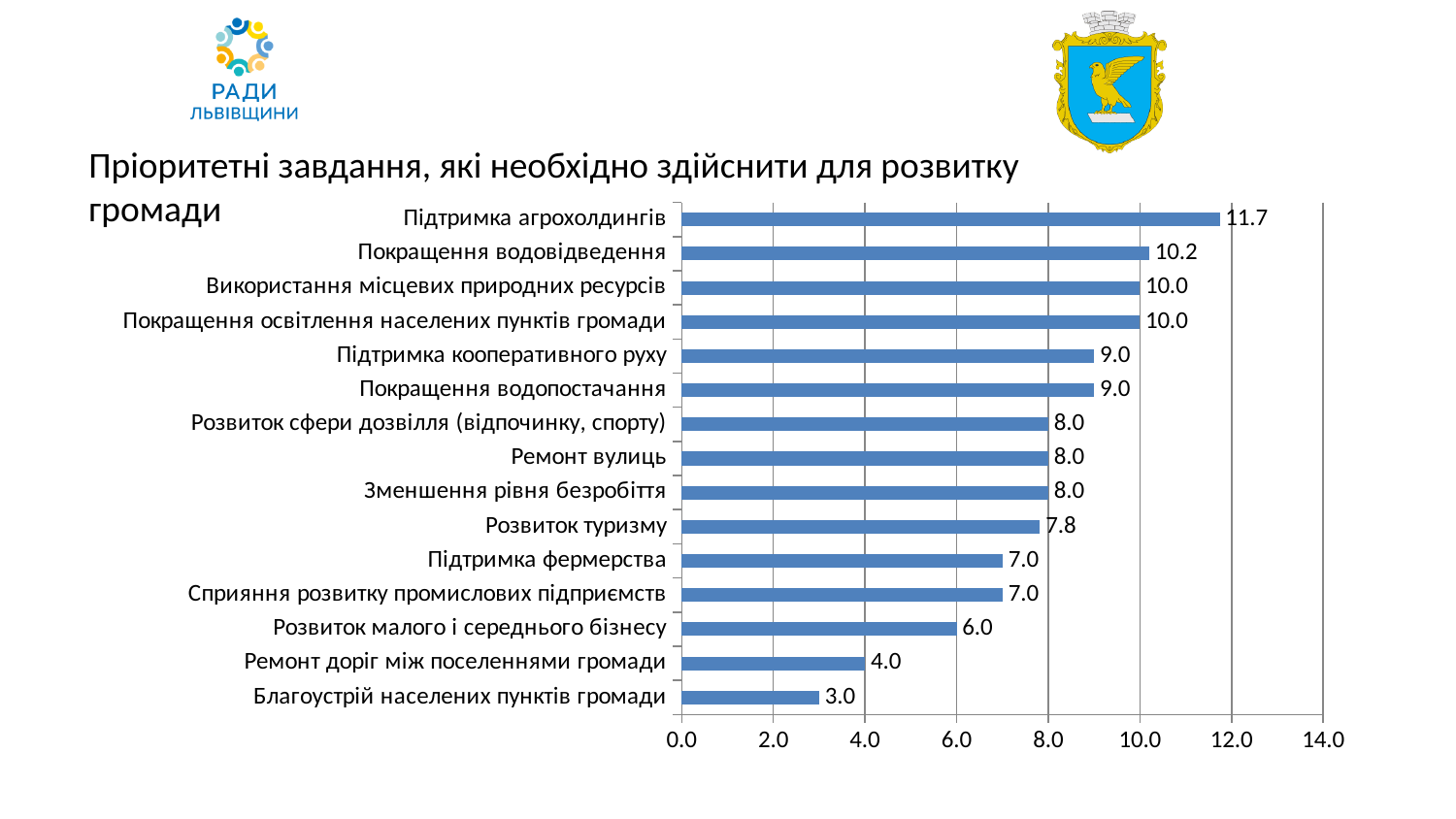
What is the value for Підтримка фермерства? 7.0 Which is larger: the value for Підтримка кооперативного руху or the value for Розвиток малого і середнього бізнесу? Підтримка кооперативного руху What is the value for Підтримка агрохолдингів? 11.7 What is the value for Розвиток туризму? 7.8 What is the difference between the values for Підтримка агрохолдингів and Покращення водовідведення? 1.5 Which category has the lowest value? Благоустрій населених пунктів громади What kind of chart is shown on the slide? bar chart Which category has the highest value? Підтримка агрохолдингів What is the value for Ремонт доріг між поселеннями громади? 4.0 Is the value for Покращення водовідведення greater or less than 10.0? greater What is the maximum value shown on the horizontal axis? 14.0 How many categories are shown in the chart? 15